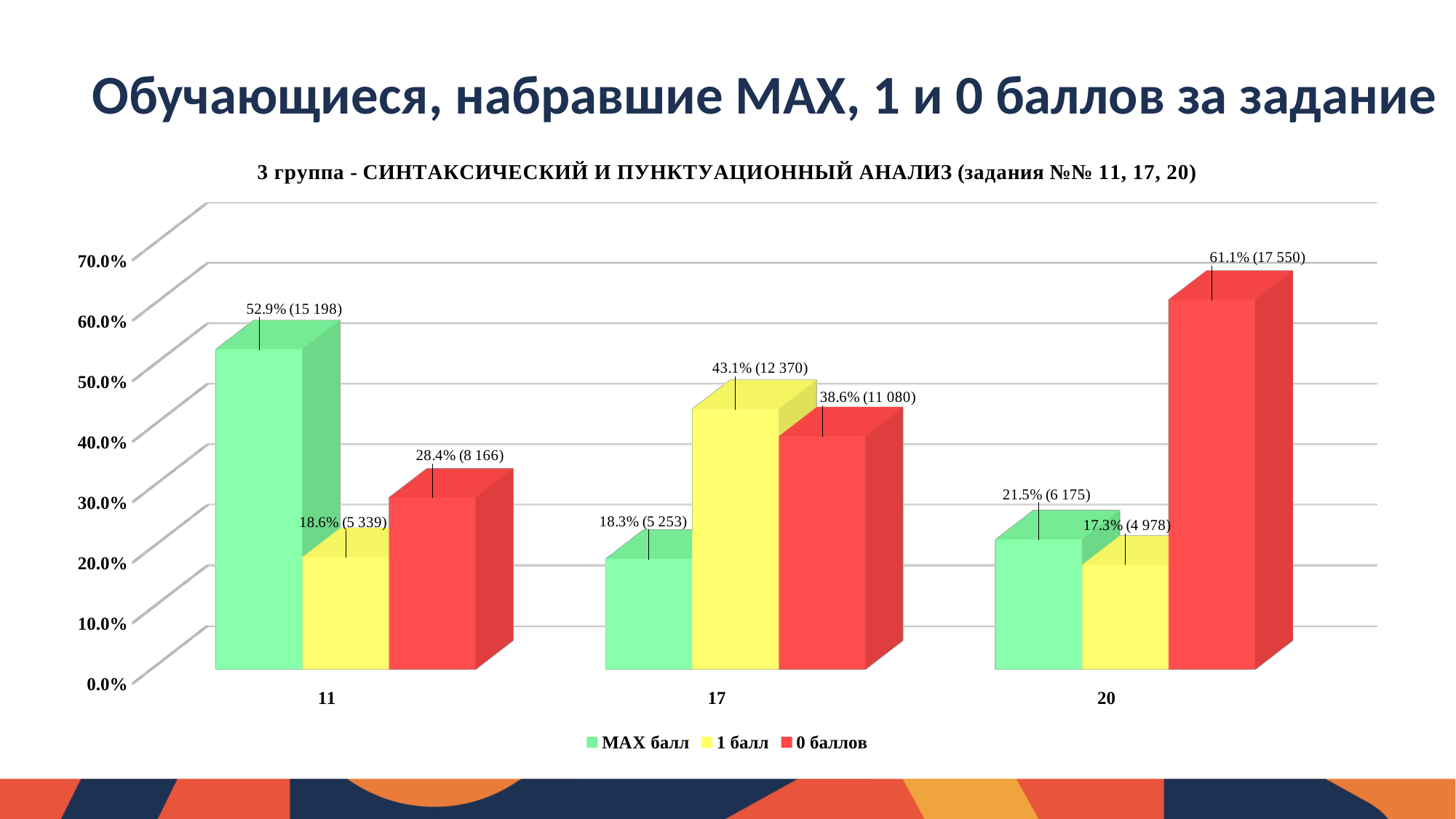
For task 17, which is larger: the 1 балл value or the 0 баллов value? 1 балл What is the value for the 1 балл series for task 17? 43.1% (12 370) What is the value for the 1 балл series for task 20? 17.3% (4 978) How many series does the legend list? 3 What is the value for the 0 баллов series for task 20? 61.1% (17 550) For which task is the 0 баллов value the highest? 20 For which task is the MAX балл value the lowest? 17 How many task categories are shown on the x axis? 3 What is the value for the MAX балл series for task 11? 52.9% (15 198) What is the difference in percentage points between the 0 баллов value for task 20 and the 0 баллов value for task 11? 32.7 Is the MAX балл value for task 11 greater or less than 50.0%? greater What kind of chart is shown on the slide? Bar chart